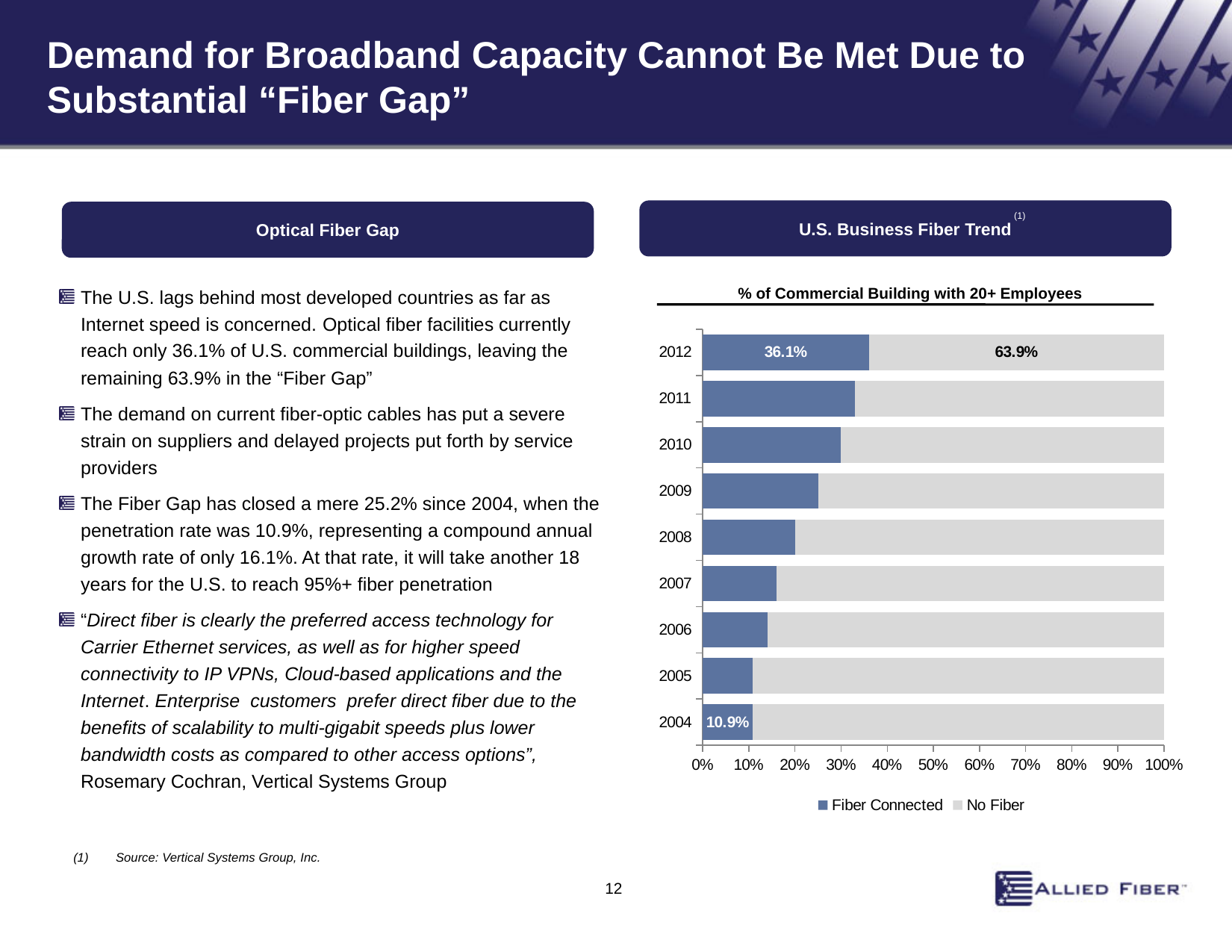
Does the Fiber Connected share rise or fall from 2004 to 2012? rise Is the Fiber Connected value for 2007 greater or less than 20%? less How many series does the legend list? 2 Which year has the lowest Fiber Connected share? 2004 and 2005 (tied at 10.9%) Which year has the highest Fiber Connected share? 2012 How many years are shown on the chart? 9 What is the Fiber Connected value for 2004? 10.9% What is the difference between the Fiber Connected values for 2012 and 2004? 25.2% What is the Fiber Connected value for 2012? 36.1% What is the total of the stacked bar for 2012? 100% What is the No Fiber value for 2012? 63.9% Is the Fiber Connected value for 2011 greater or less than 30%? greater